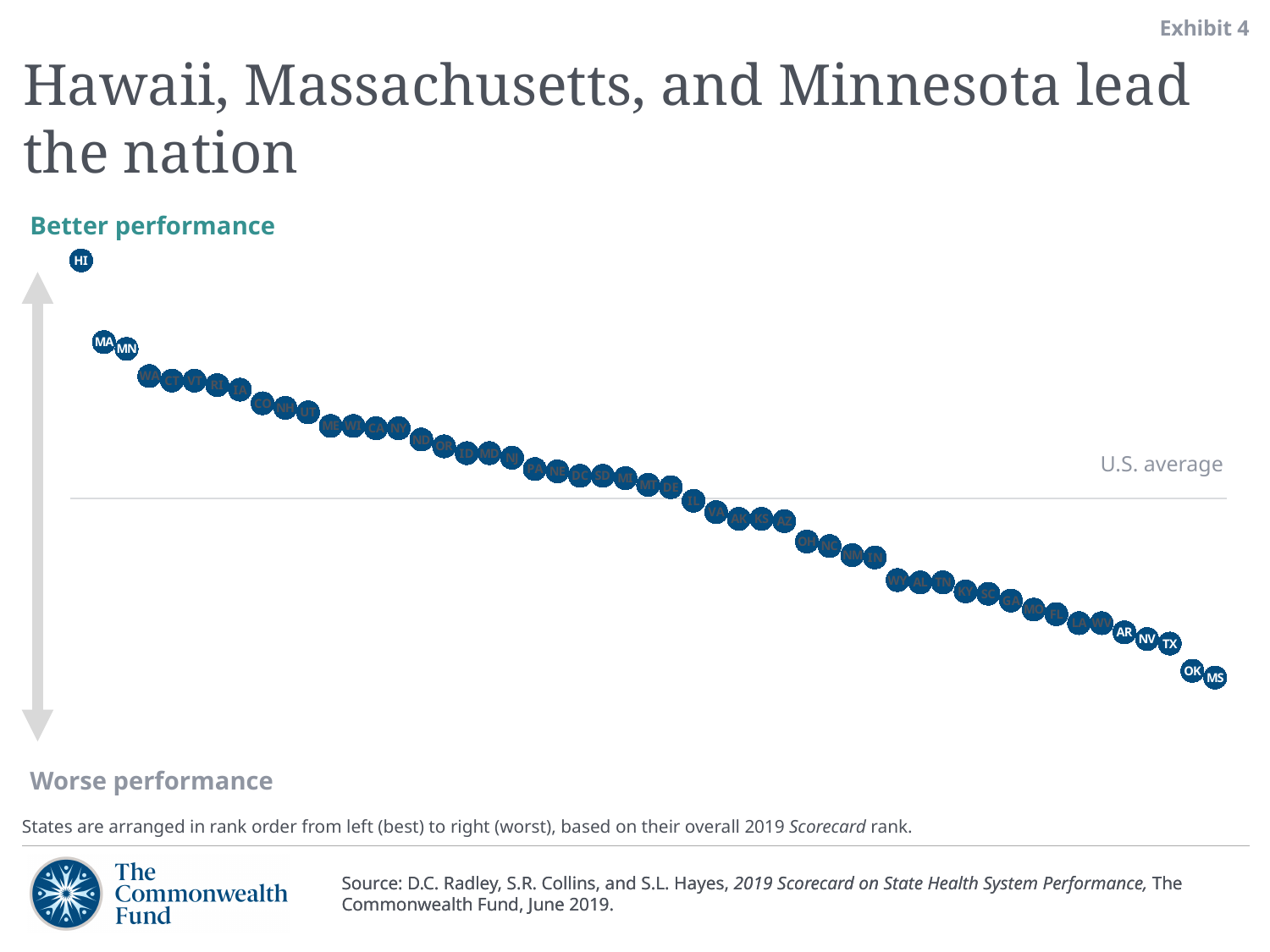
What is the title of the slide? Hawaii, Massachusetts, and Minnesota lead the nation Which two states appear immediately after HI at the top of the ranking? MA and MN Which state is plotted higher on the chart, MA or TX? MA Which state is plotted highest (best performance) on the chart? HI Which state is plotted higher on the chart, HI or MS? HI Which state is plotted lower on the chart, AR or NV? NV What does the horizontal grey line across the chart represent? U.S. average Which state is plotted lowest (worst performance) on the chart? MS Do the plotted points rise or fall moving from left to right across the chart? Fall What kind of chart is shown on the slide? Scatter (dot) chart